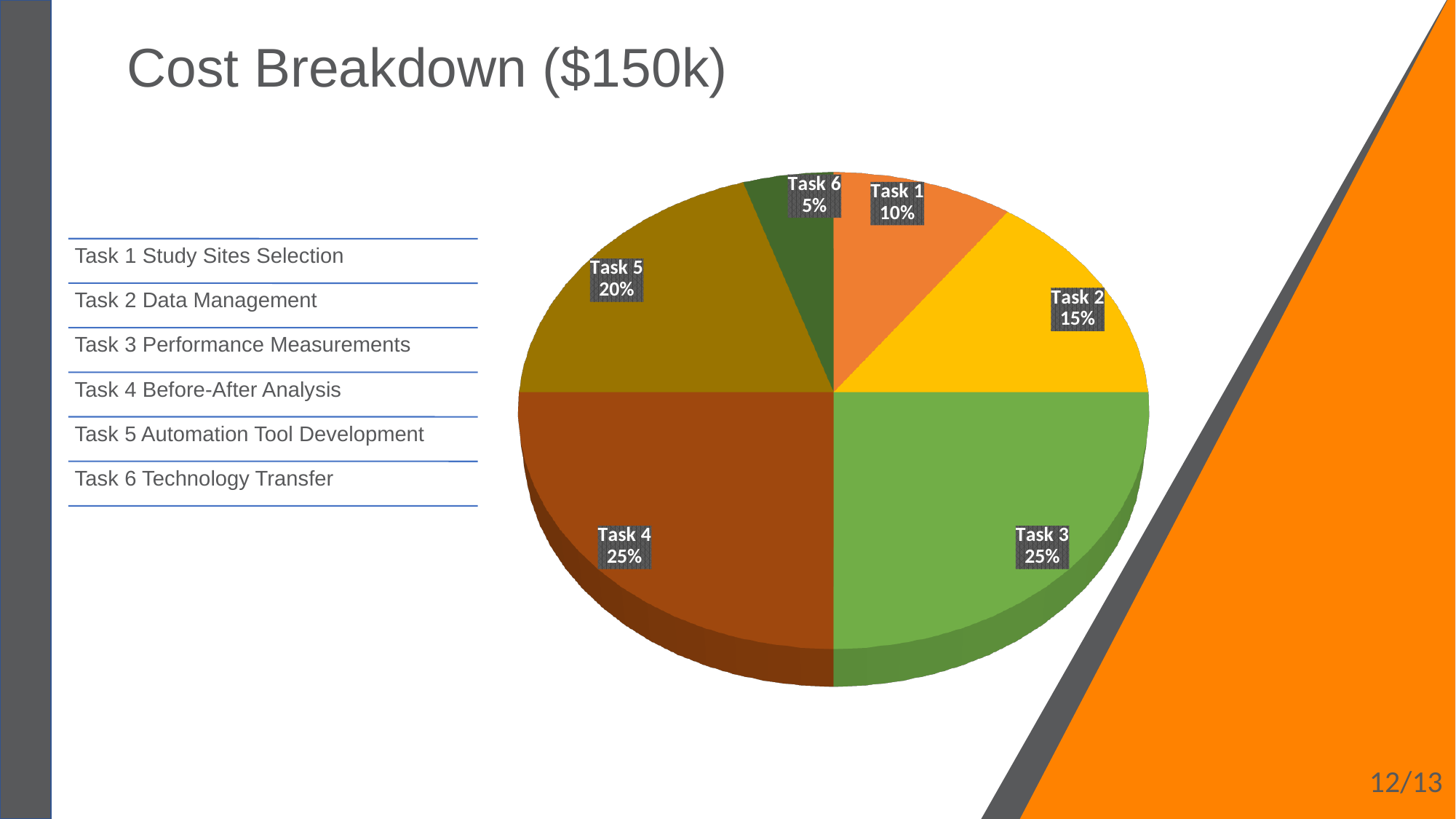
What share of the pie does Task 5 represent? 20% What is the difference in percentage points between Task 5 and Task 2? 5% What is the difference in percentage points between Task 4 and Task 6? 20% Which task has the smallest slice of the pie? Task 6 What colour is the slice for Task 2? yellow Which is larger, the slice for Task 1 or the slice for Task 2? Task 2 What share of the pie does Task 2 represent? 15% What share of the pie does Task 1 represent? 10% What is the title of the slide containing the pie chart? Cost Breakdown ($150k) What kind of chart is shown on the slide? pie chart How many slices does the pie chart have? 6